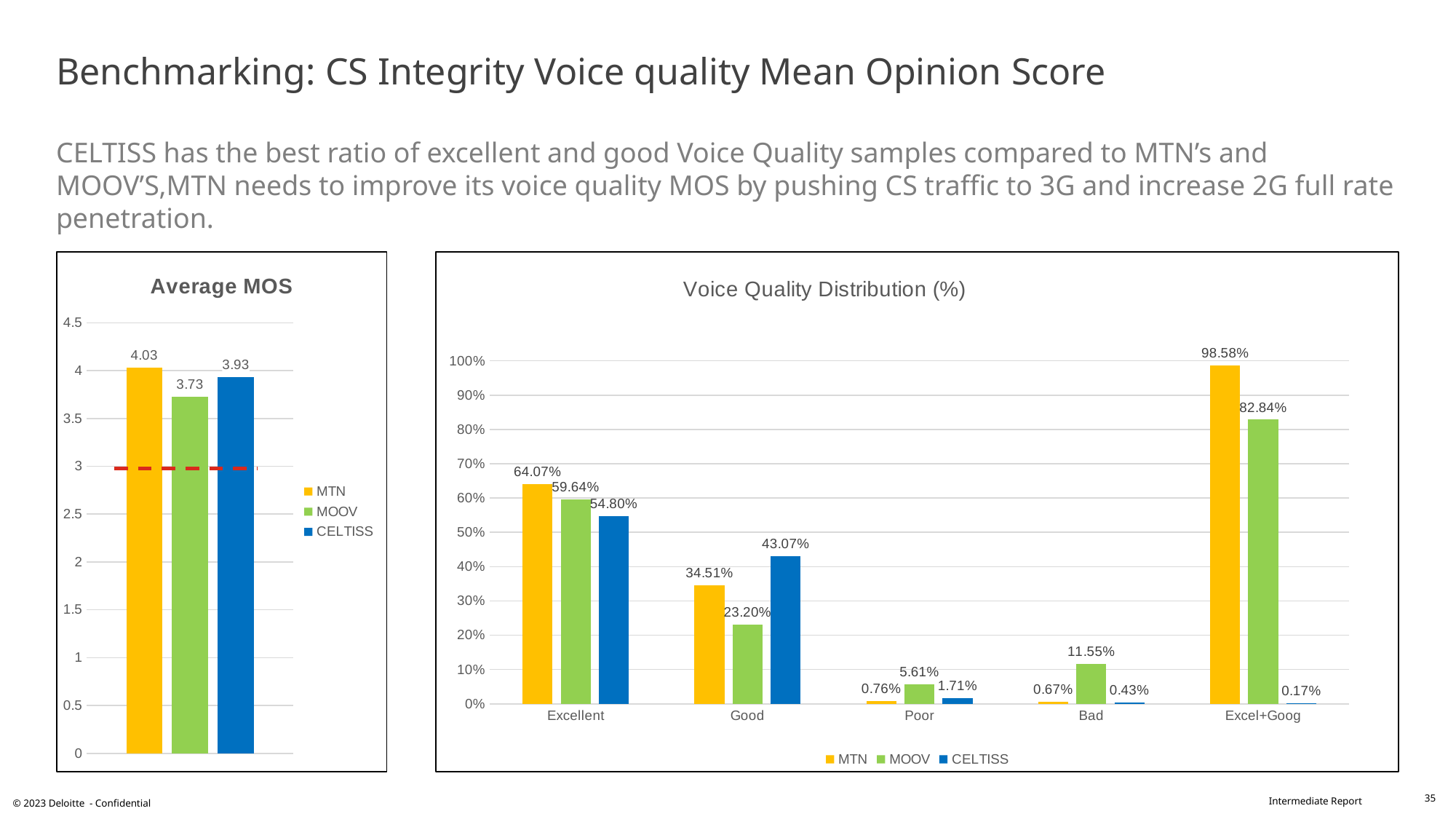
In the Average MOS chart, how many series does the legend list? 3 In the Voice Quality Distribution (%) chart, what is the value for MOOV in the Bad category? 11.55% In the Average MOS chart, which operator has the lowest average MOS? MOOV In the Average MOS chart, what is the difference between MTN's and MOOV's values? 0.3 In the Voice Quality Distribution (%) chart, what is the difference between MTN's and MOOV's values in the Excel+Goog category? 15.74% In the Voice Quality Distribution (%) chart, how many categories are shown on the x axis? 5 What kind of chart is the Voice Quality Distribution (%) chart? Bar chart In the Average MOS chart, what is the value for MTN? 4.03 In the Voice Quality Distribution (%) chart, what is the value for CELTISS in the Good category? 43.07% In the Voice Quality Distribution (%) chart, which is larger in the Good category: MTN or MOOV? MTN In the Voice Quality Distribution (%) chart, which operator has the highest value in the Excellent category? MTN In the Voice Quality Distribution (%) chart, which colour represents CELTISS? Blue